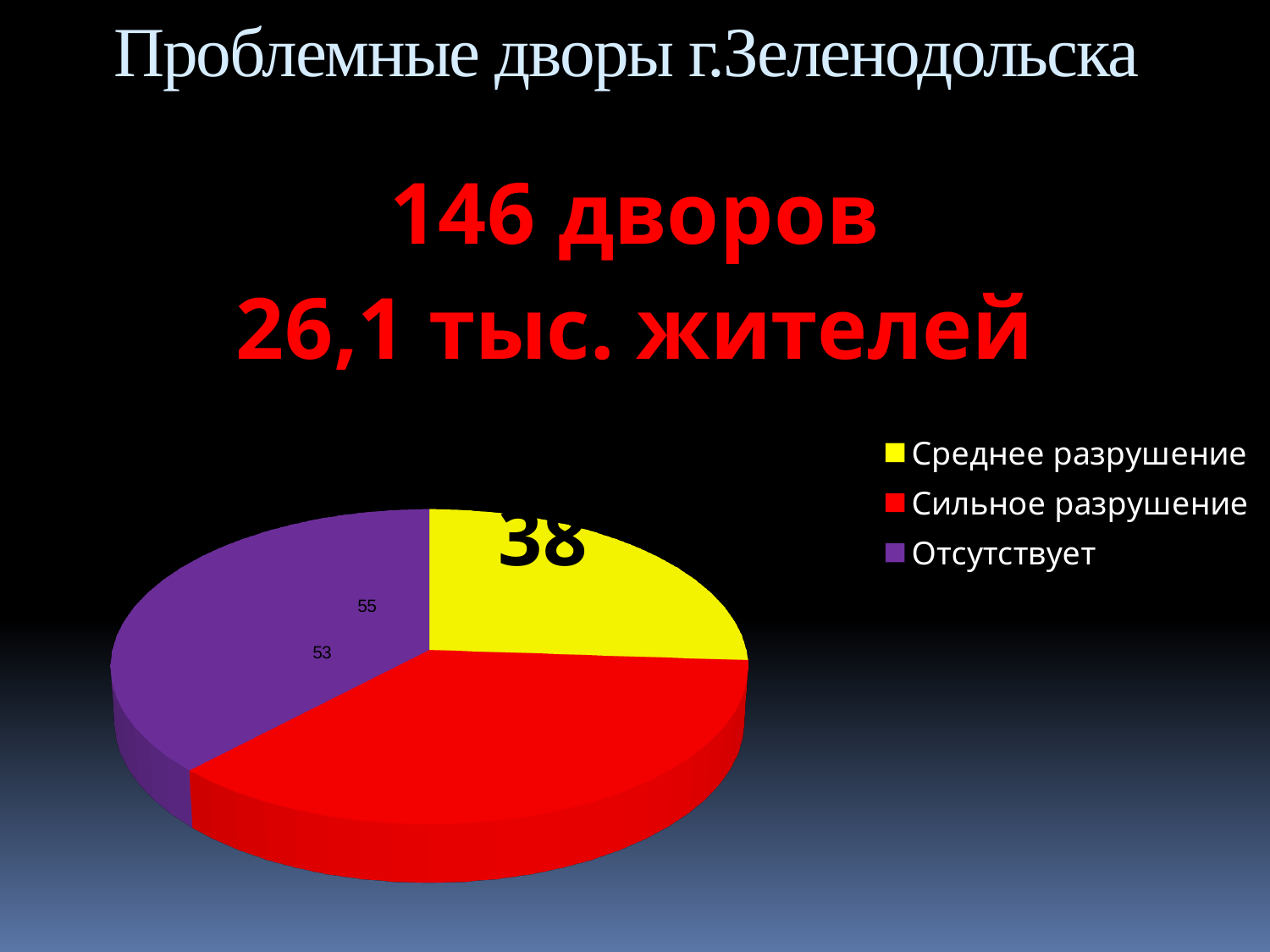
How many slices does the pie chart have? 3 Which slice is larger in the pie chart: "Среднее разрушение" or "Отсутствует"? Отсутствует How many entries does the legend of the pie chart list? 3 What colour is the "Сильное разрушение" slice in the pie chart? red What is the total number of yards (дворов) stated on the slide that the pie chart breaks down? 146 What kind of chart is shown on the slide? pie chart What value is shown for the "Среднее разрушение" slice of the pie chart? 38 What colour is the "Отсутствует" slice in the pie chart? purple Which slice is larger in the pie chart: "Среднее разрушение" or "Сильное разрушение"? Сильное разрушение Which category has the smallest slice in the pie chart? Среднее разрушение